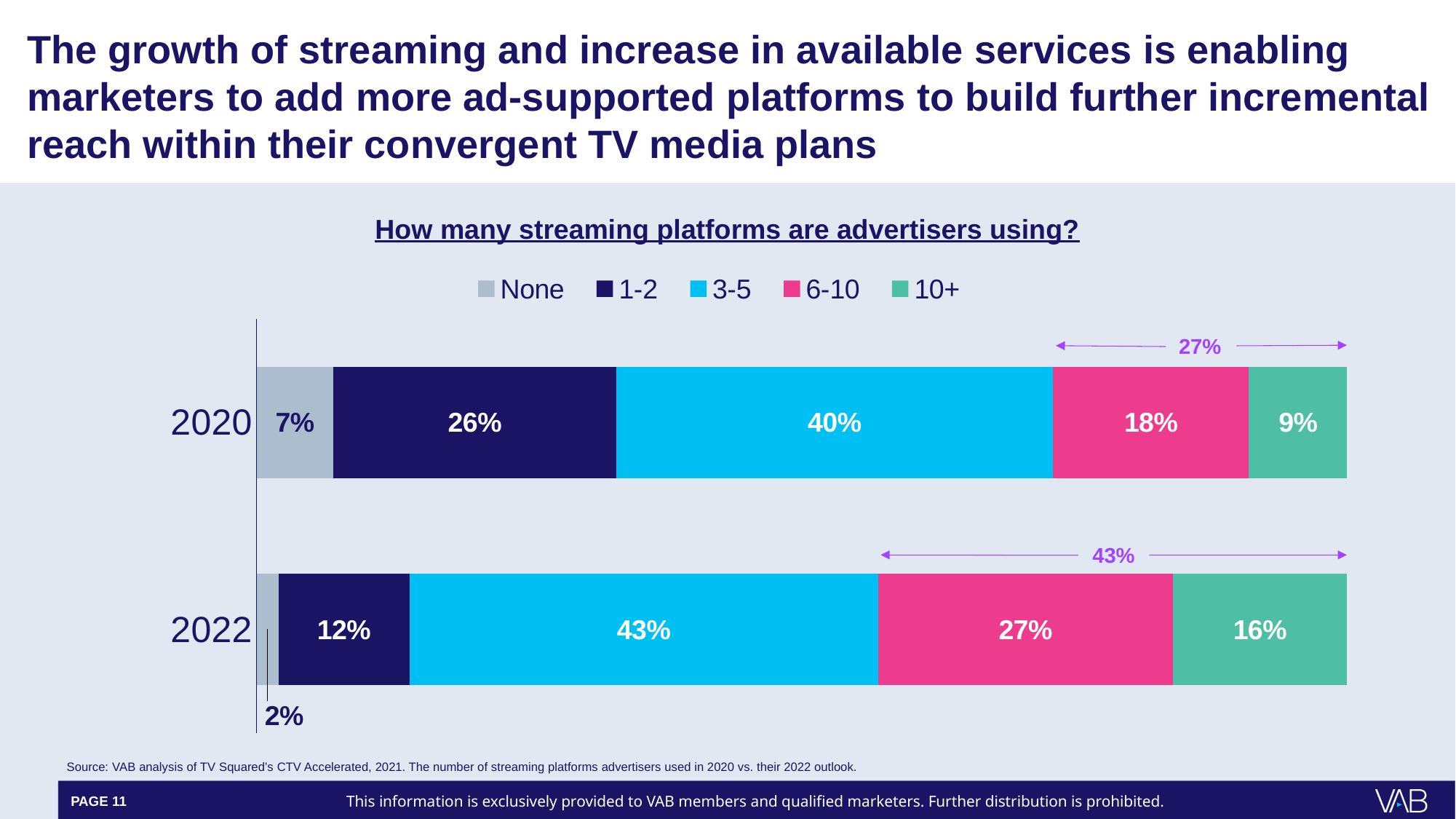
What kind of chart is shown on the slide? Stacked bar chart How many years (bars) are shown in the chart? 2 What is the value for 'None' in 2022? 2% Which segment is the largest in the 2022 bar? 3-5 What percentage of advertisers are expected to use 6-10 streaming platforms in 2022? 27% What is the combined share of advertisers using 6-10 and 10+ platforms in 2022, as labelled by the arrow? 43% What is the difference between the 1-2 values for 2020 and 2022? 14% What is the value for '10+' in 2020? 9% Which segment is the smallest in the 2020 bar? None Is the 10+ value larger in 2020 or 2022? 2022 How many series does the legend list? 5 What percentage of advertisers used 3-5 streaming platforms in 2020? 40%